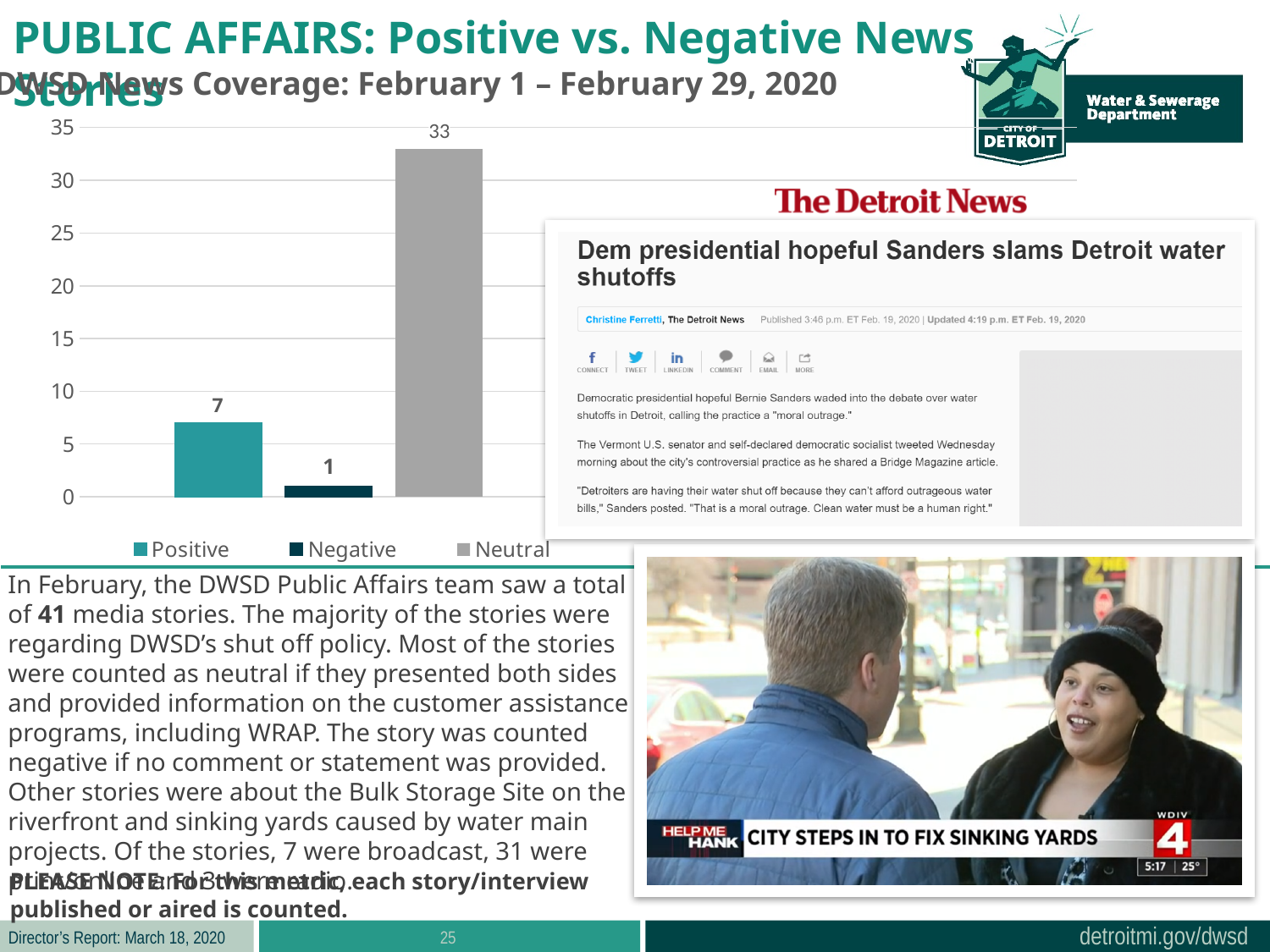
What is the difference between the Neutral and Positive values? 26 Is the value for Neutral greater or less than 30? greater What is the difference between the Positive and Negative values? 6 Which category has the highest value in the chart? Neutral What is the value for Negative stories in the chart? 1 What is the total of the Positive, Negative and Neutral values in the chart? 41 What kind of chart is shown on the slide? Bar chart What is the value for Positive stories in the chart? 7 Which category has the lowest value in the chart? Negative How many series does the chart legend list? 3 What is the value for Neutral stories in the chart? 33 Which is larger, the Positive value or the Negative value? Positive